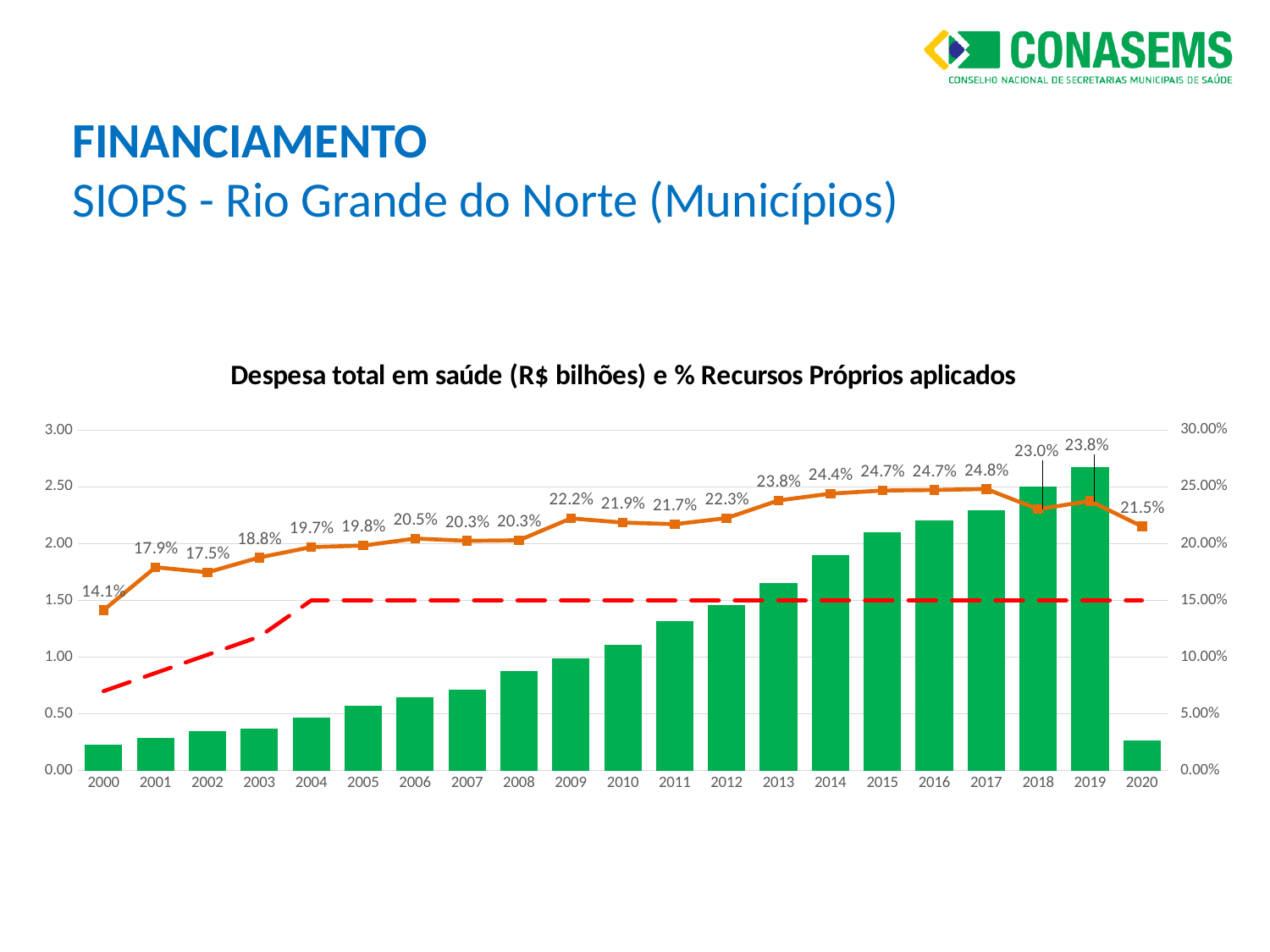
What is the % Recursos Próprios aplicados value shown for 2000? 14.1% By how many percentage points does the % Recursos Próprios aplicados value for 2019 exceed the value for 2018? 0.8 percentage points In which year is the % Recursos Próprios aplicados line at its highest? 2017 Is the Despesa total em saúde bar for 2019 greater or less than 2.50? greater Is the Despesa total em saúde bar for 2020 greater or less than 0.50? less What is the % Recursos Próprios aplicados value shown for 2017? 24.8% What kind of chart is shown on the slide? A combined bar and line chart How many years are shown on the x axis of the chart? 21 In which year is the % Recursos Próprios aplicados line at its lowest? 2000 What is the % Recursos Próprios aplicados value shown for 2020? 21.5% Which year has the higher % Recursos Próprios aplicados value, 2009 or 2010? 2009 Do the Despesa total em saúde bars generally rise or fall from 2000 to 2019? rise